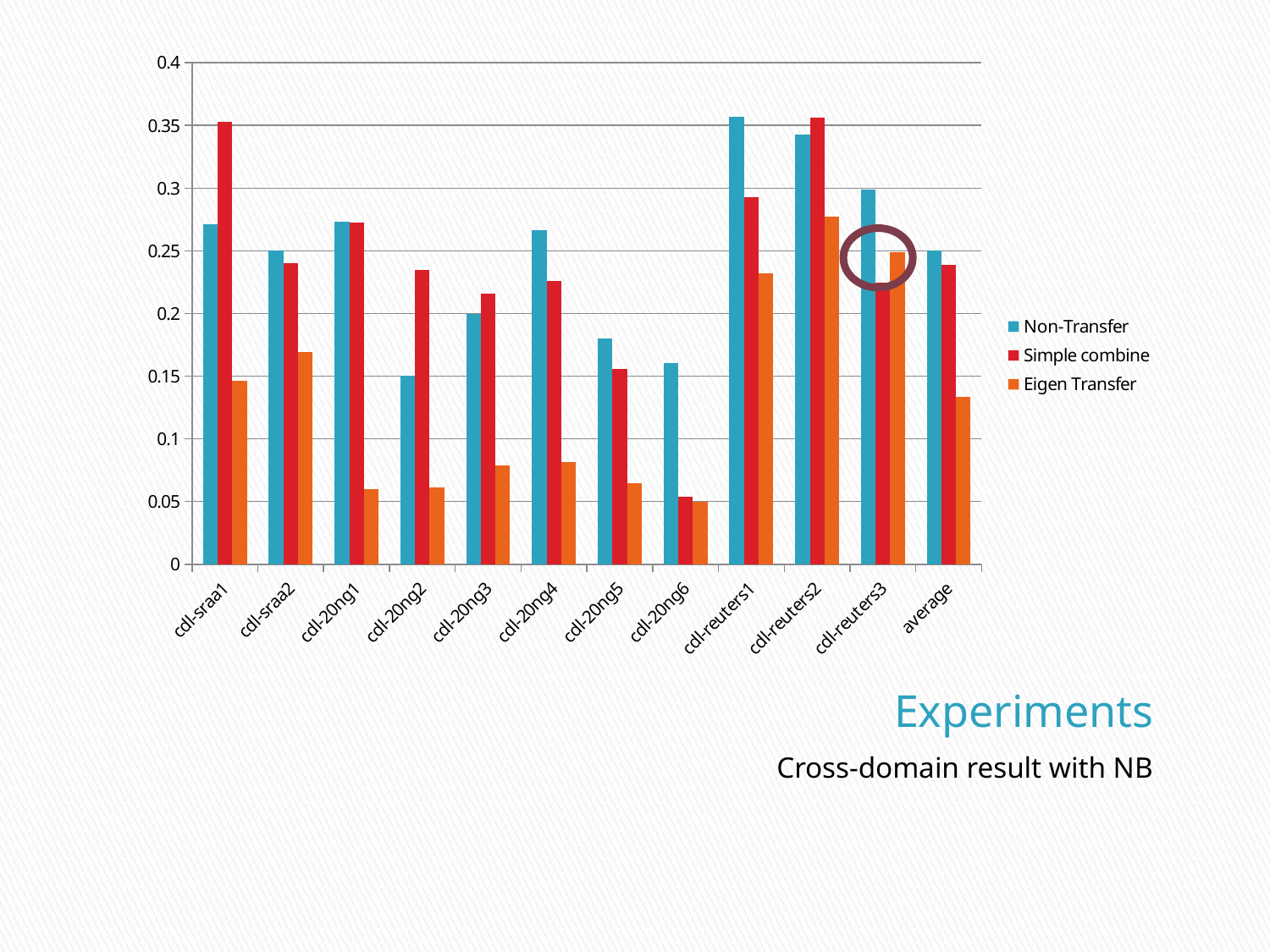
Is the Non-Transfer value for cdl-20ng5 greater or less than 0.2? less Which category has the highest Eigen Transfer value? cdl-reuters2 Is the Eigen Transfer value for cdl-reuters2 greater or less than 0.25? greater How many categories are shown along the x axis? 12 For cdl-sraa1, which is larger: Non-Transfer or Simple combine? Simple combine For cdl-20ng4, which is larger: Non-Transfer or Simple combine? Non-Transfer How many series does the legend list? 3 What kind of chart is shown on the slide? bar chart Is the Simple combine value for cdl-20ng2 greater or less than 0.2? greater Which category has the lowest Simple combine value? cdl-20ng6 Which category on the x axis has a circle drawn around its bars? cdl-reuters3